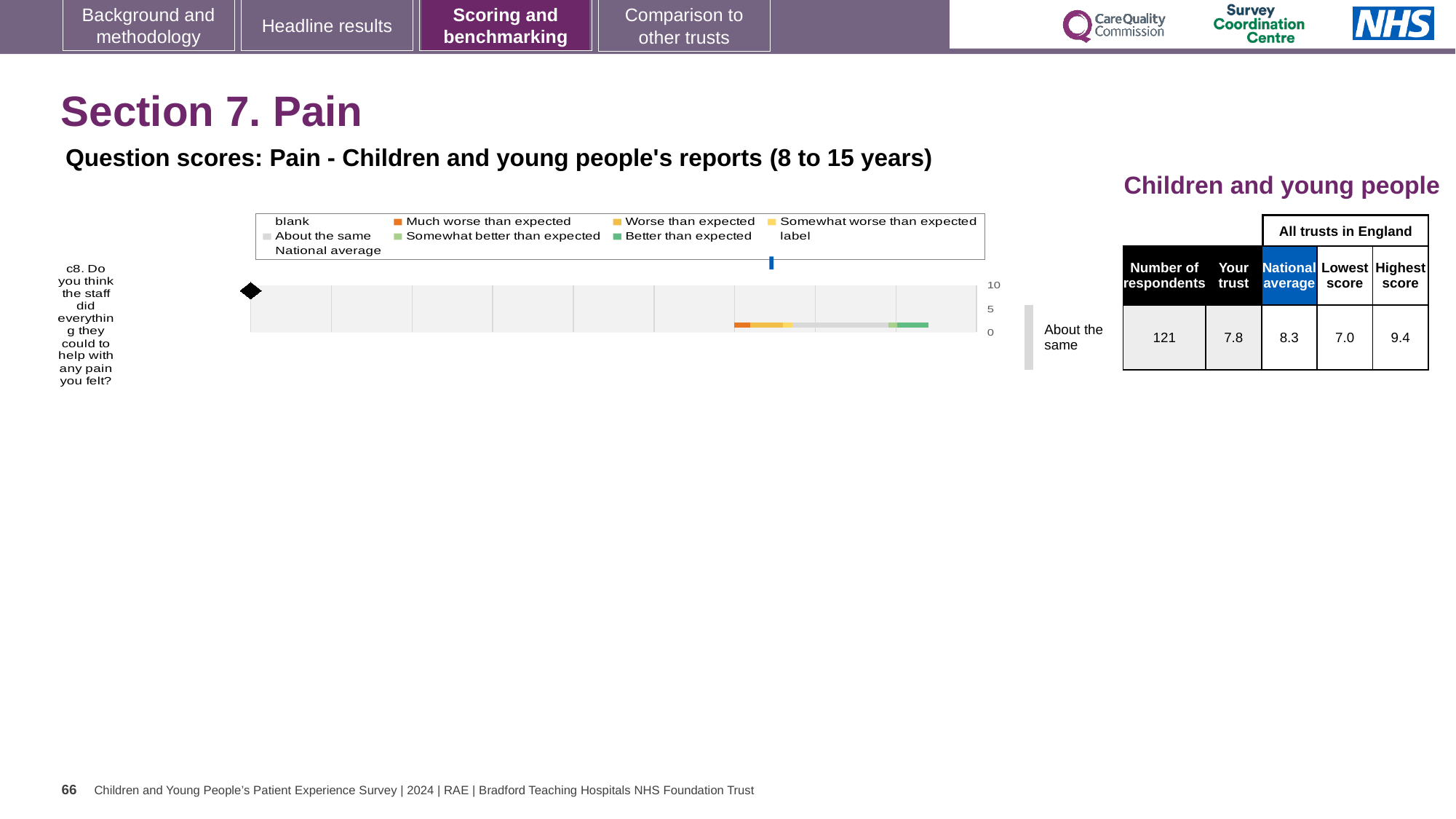
Which is larger for question c8: the trust's score or the national average? national average According to the table beside the chart, what is the national average score for question c8? 8.3 Which colour does the legend use for 'Much worse than expected'? orange According to the table beside the chart, how many respondents answered question c8? 121 According to the table beside the chart, what is the highest score among all trusts in England for question c8? 9.4 What is the highest tick value shown on the chart's score axis? 10 According to the table beside the chart, what is the lowest score among all trusts in England for question c8? 7.0 What kind of chart is shown on the slide? bar chart How many survey questions (categories) are plotted on the chart? 1 What is the difference between the highest score (9.4) and the lowest score (7.0) for question c8? 2.4 What is the question code of the item plotted on the chart? c8 According to the table beside the chart, what is the 'Your trust' score for question c8? 7.8